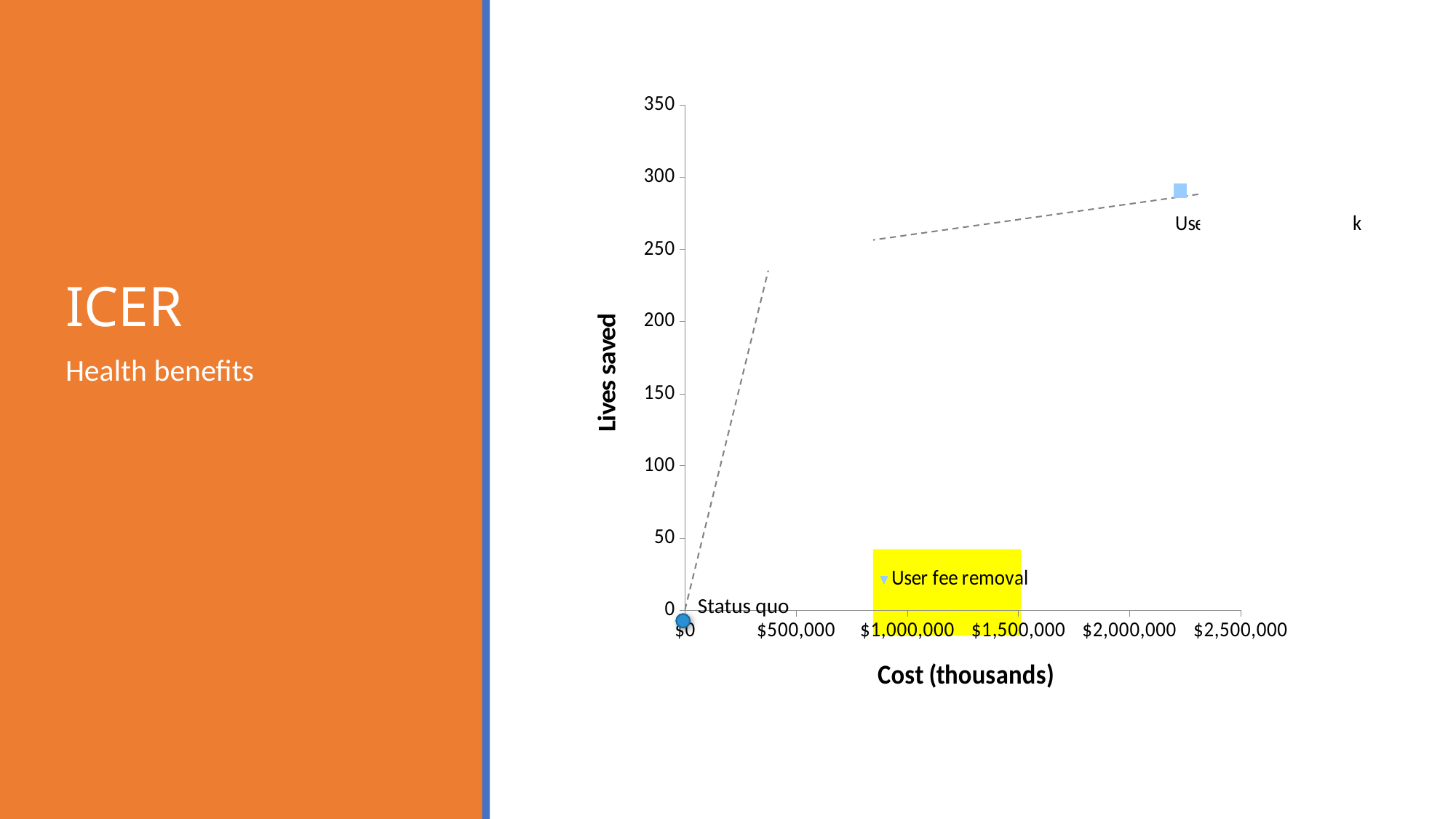
How many lives saved are plotted for Status quo? 0 What is the title of the vertical axis of the chart? Lives saved Is the number of lives saved for the User fee removal point greater or less than 250? less What is the cost plotted for Status quo? $0 Is the number of lives saved for the User fee removal point greater or less than 300? less Which plotted point has the lowest number of lives saved? Status quo What is the title of the horizontal axis of the chart? Cost (thousands) What is the highest value shown on the Lives saved axis? 350 What kind of chart is shown on the slide? scatter chart Is the cost for the User fee removal point greater or less than $2,000,000? less Which point has more lives saved, Status quo or User fee removal? User fee removal